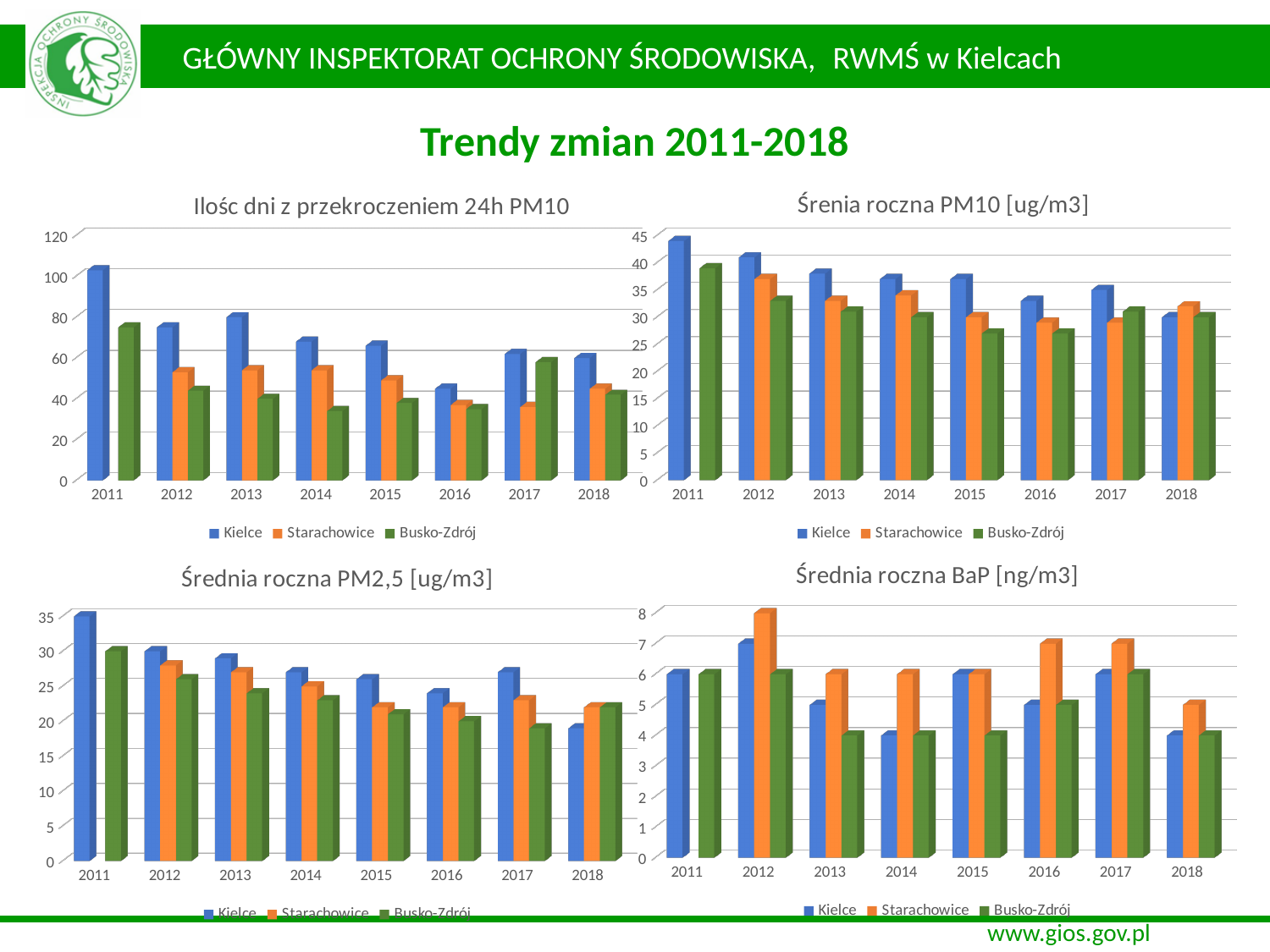
How many series does the legend of the "Śrenia roczna PM10 [ug/m3]" chart list? 3 How many years are shown on the x axis of the "Średnia roczna BaP [ng/m3]" chart? 8 In the "Ilośc dni z przekroczeniem 24h PM10" chart, is the value for Kielce in 2011 greater or less than 100? greater In the "Średnia roczna BaP [ng/m3]" chart, which series has the highest bar in 2012? Starachowice What kind of chart is "Ilośc dni z przekroczeniem 24h PM10"? bar chart In the "Średnia roczna PM2,5 [ug/m3]" chart, which year has the lowest value for Kielce? 2018 In the "Ilośc dni z przekroczeniem 24h PM10" chart, which is larger in 2017: Kielce or Starachowice? Kielce In the "Ilośc dni z przekroczeniem 24h PM10" chart, which year has the highest value for Kielce? 2011 In the "Średnia roczna BaP [ng/m3]" chart, is the value for Starachowice in 2012 greater or less than 7? greater In the "Średnia roczna PM2,5 [ug/m3]" chart, do the Kielce values generally rise or fall from 2011 to 2018? fall In the "Śrenia roczna PM10 [ug/m3]" chart, is the value for Kielce in 2011 greater or less than 40? greater What are the three legend entries in the "Ilośc dni z przekroczeniem 24h PM10" chart? Kielce, Starachowice, Busko-Zdrój